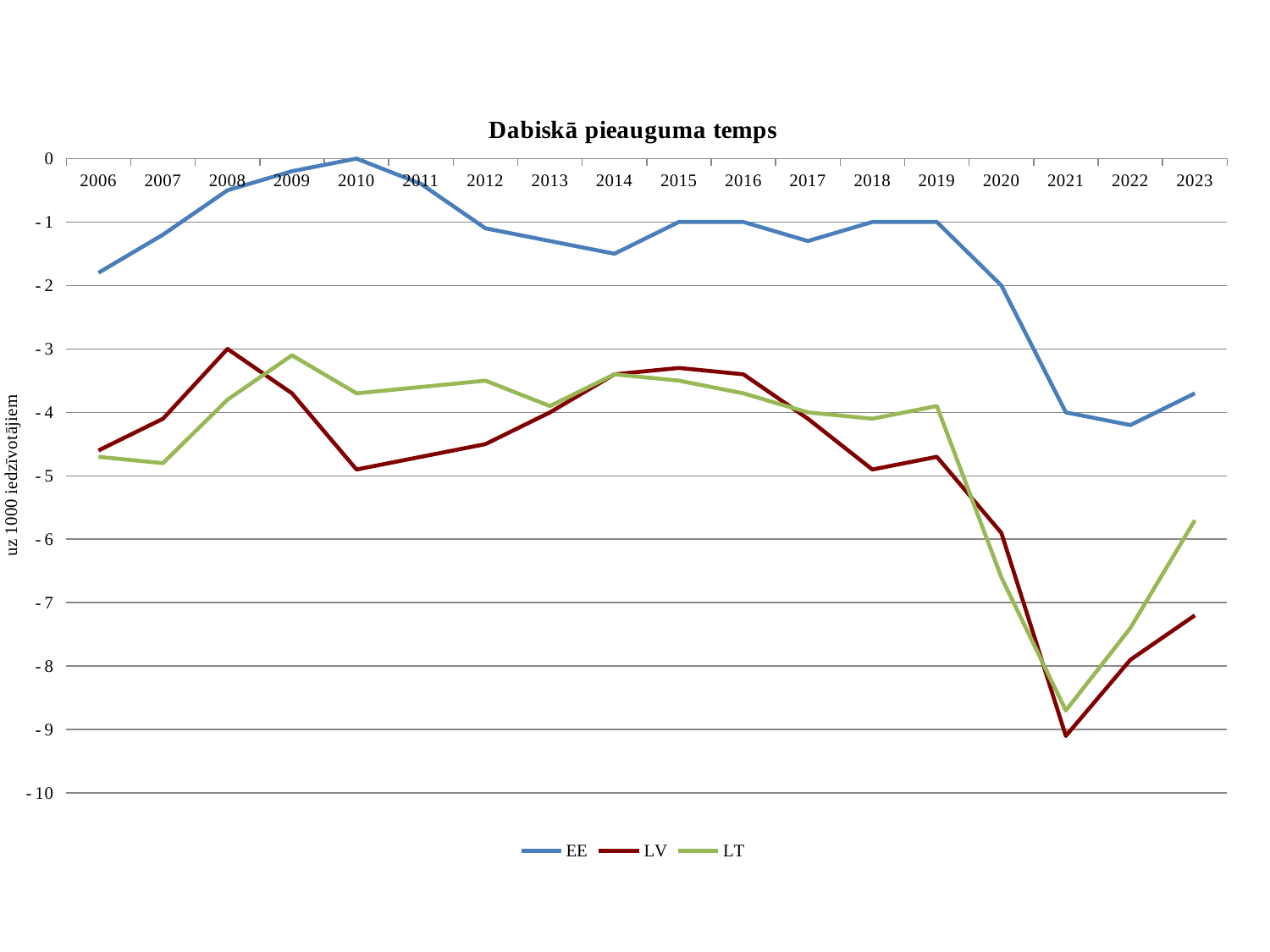
How many years are shown on the x axis? 18 Is the value for LV in 2021 greater or less than -9? less In 2023, which series has the higher value, LV or LT? LT Is the value for LT in 2023 greater or less than -6? greater What is the title of the chart? Dabiskā pieauguma temps In which year does the EE series reach its highest value? 2010 How many series does the legend list? 3 What is the value for EE in 2010? 0 Does the EE series rise or fall from 2019 to 2021? fall What is the label on the vertical axis? uz 1000 iedzīvotājiem In which year does the LV series reach its lowest value? 2021 What kind of chart is shown on the slide? line chart